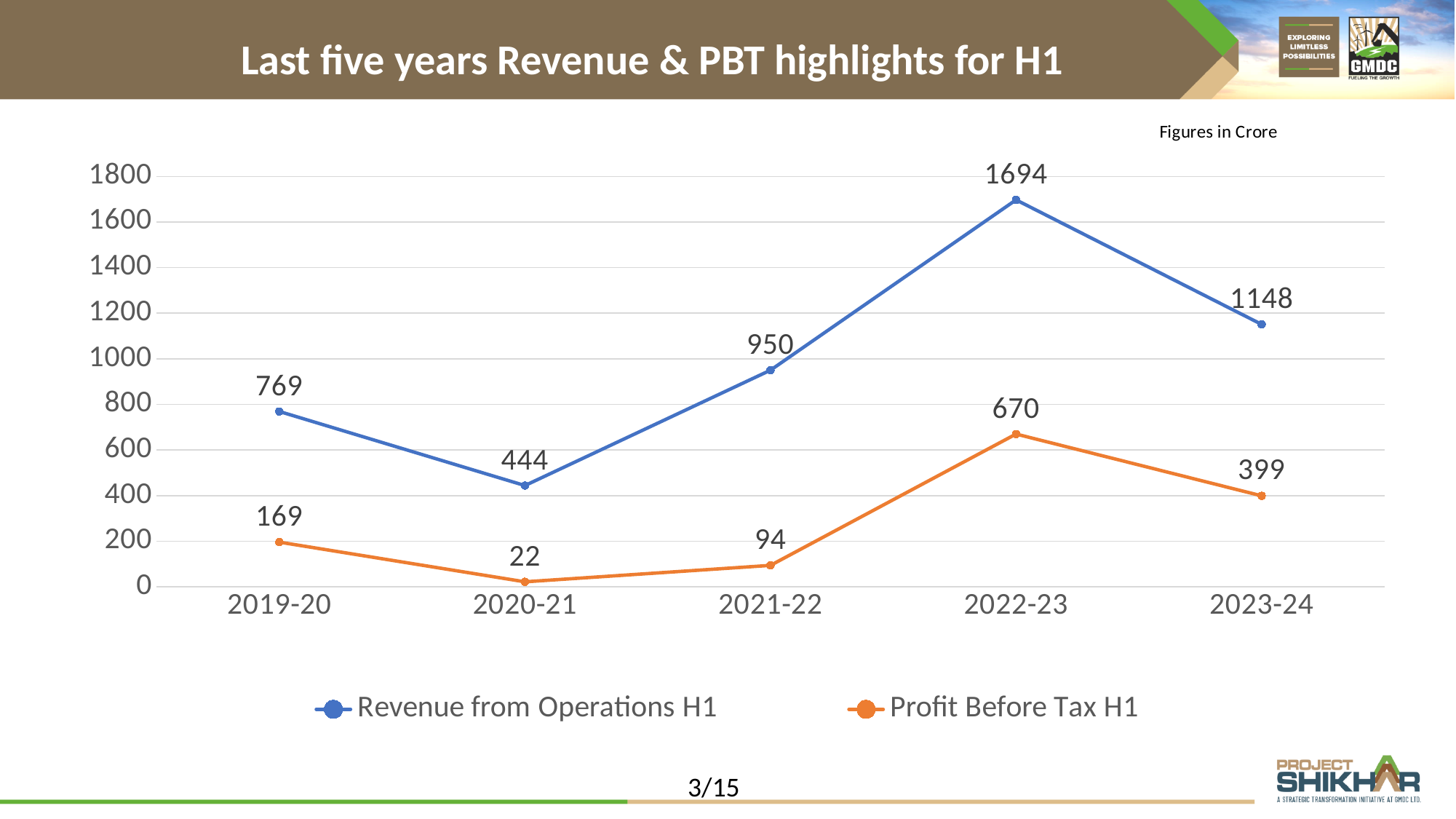
How many series does the legend list? 2 Which is larger: Revenue from Operations H1 in 2021-22 or in 2023-24? 2023-24 What is the Revenue from Operations H1 value for 2022-23? 1694 Is the Profit Before Tax H1 value for 2022-23 greater or less than 600? greater Which year has the lowest Revenue from Operations H1? 2020-21 What is the Profit Before Tax H1 value for 2020-21? 22 How many years are shown on the x axis? 5 What is the difference between Revenue from Operations H1 and Profit Before Tax H1 in 2023-24? 749 What is the Revenue from Operations H1 value for 2019-20? 769 What kind of chart is shown on the slide? Line chart Does Revenue from Operations H1 rise or fall from 2022-23 to 2023-24? Fall Which year has the highest Profit Before Tax H1? 2022-23